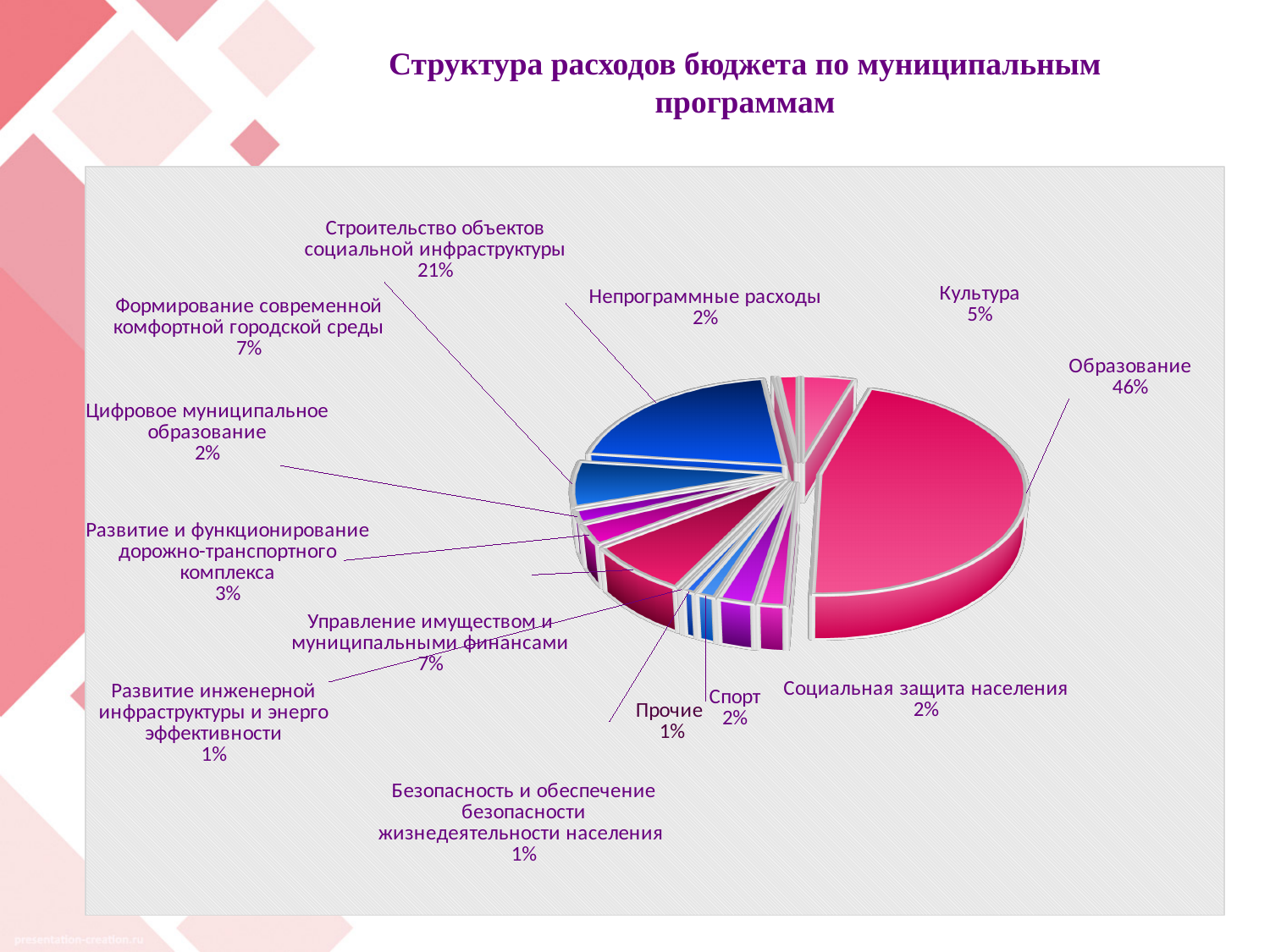
What is the value for Развитие и функционирование дорожно-транспортного комплекса? 3% What is the value for Управление имуществом и муниципальными финансами? 7% Which is larger: the share of Культура or the share of Спорт? Культура What is the value for Культура? 5% What share of the pie does Образование take? 46% What is the difference between the shares of Формирование современной комфортной городской среды and Цифровое муниципальное образование? 5% What is the title of the chart? Структура расходов бюджета по муниципальным программам Which category has the largest share of the pie? Образование What type of chart is shown on the slide? pie chart What is the difference between the shares of Образование and Строительство объектов социальной инфраструктуры? 25% What is the value for Строительство объектов социальной инфраструктуры? 21%